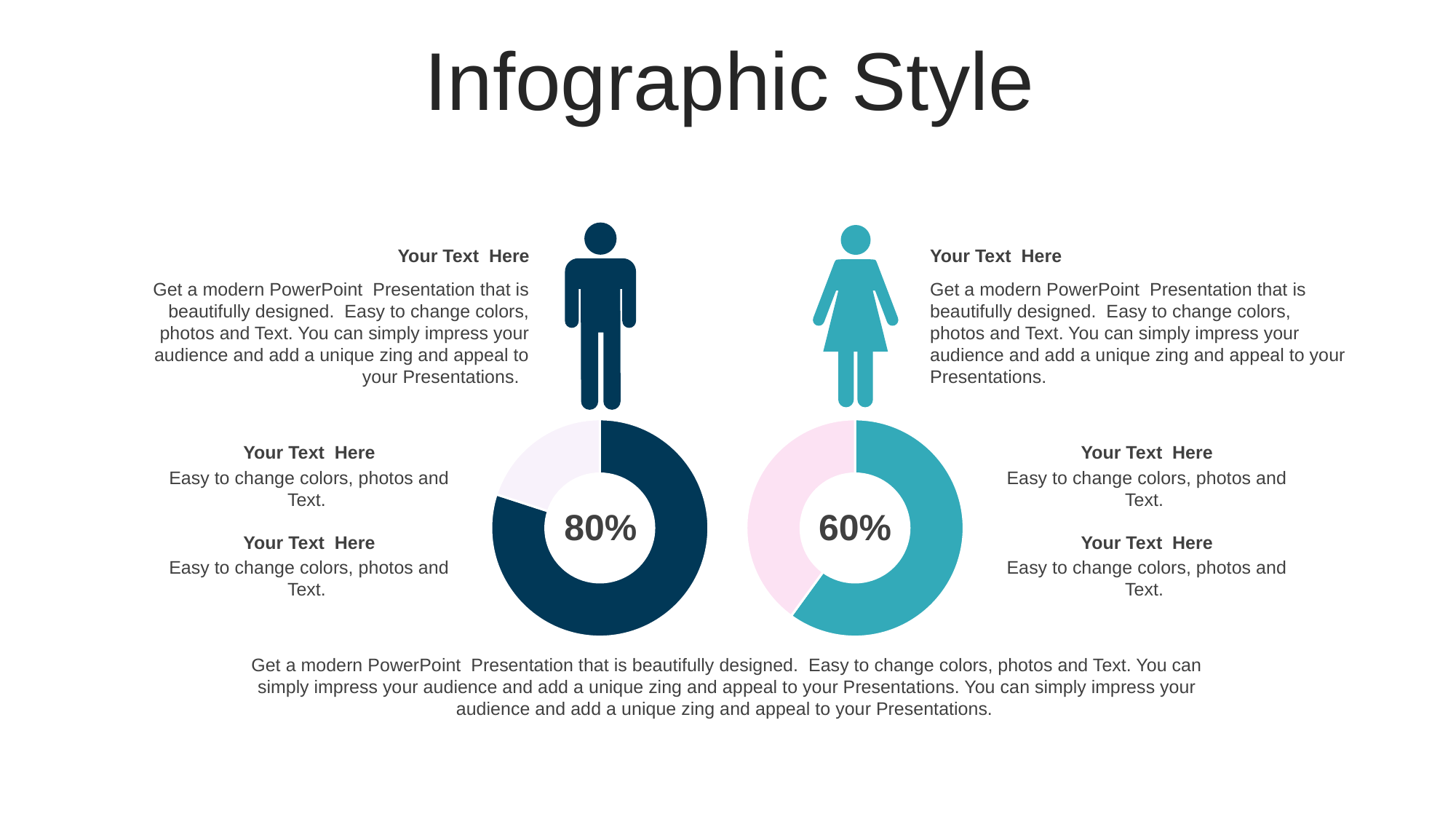
What colour is the filled portion of the right donut chart? teal What kind of chart is used below each figure on the slide? donut chart What value is shown in the centre of the right donut chart (below the female figure)? 60% Which donut chart shows the larger percentage, the left one or the right one? the left one What colour is the filled portion of the left donut chart? dark navy blue In the right donut chart, what share of the ring is left unfilled (the light pink segment)? 40% What value is shown in the centre of the left donut chart (below the male figure)? 80% Is the value in the right donut chart greater or less than 50%? greater How many donut charts are on the slide? 2 In the left donut chart, what share of the ring is left unfilled (the light segment)? 20% What is the difference between the percentage in the left donut chart and the percentage in the right donut chart? 20%